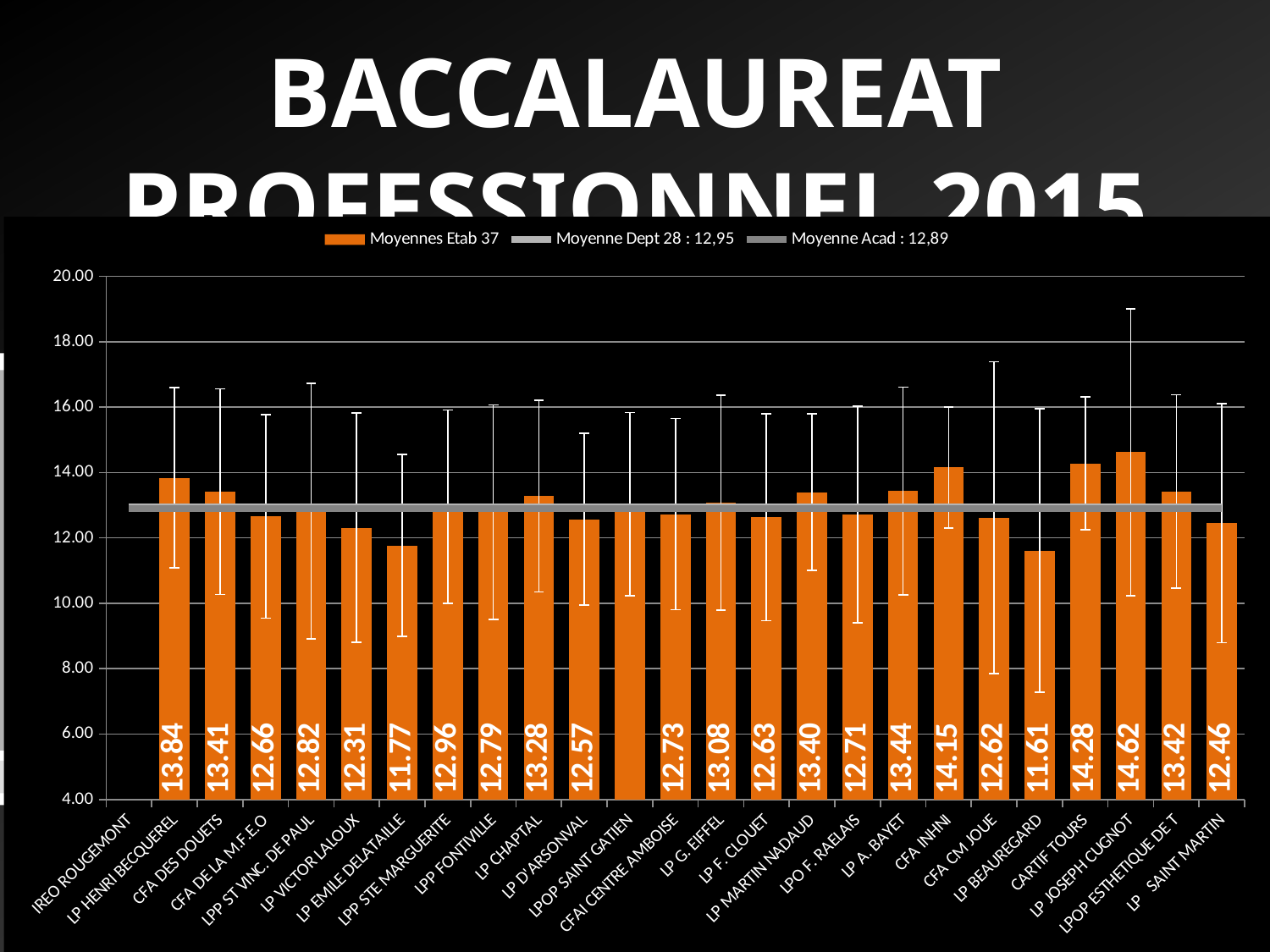
What value does the legend give for Moyenne Dept 28? 12,95 What is the average shown for CFA INHNI? 14.15 What is the average shown for LP CHAPTAL? 13.28 Which has the higher average, CARTIF TOURS or LP HENRI BECQUEREL? CARTIF TOURS Which establishment has the lowest average (Moyennes Etab 37)? LP BEAUREGARD What is the difference between the averages of LP JOSEPH CUGNOT and LP BEAUREGARD? 3.01 How many series does the legend list? 3 What is the average shown for LP EMILE DELATAILLE? 11.77 What kind of chart is shown on the slide? bar chart What is the difference between the averages of CFA INHNI and LP VICTOR LALOUX? 1.84 Is the value for LP BEAUREGARD greater or less than 12.00? less Which establishment has the highest average (Moyennes Etab 37)? LP JOSEPH CUGNOT